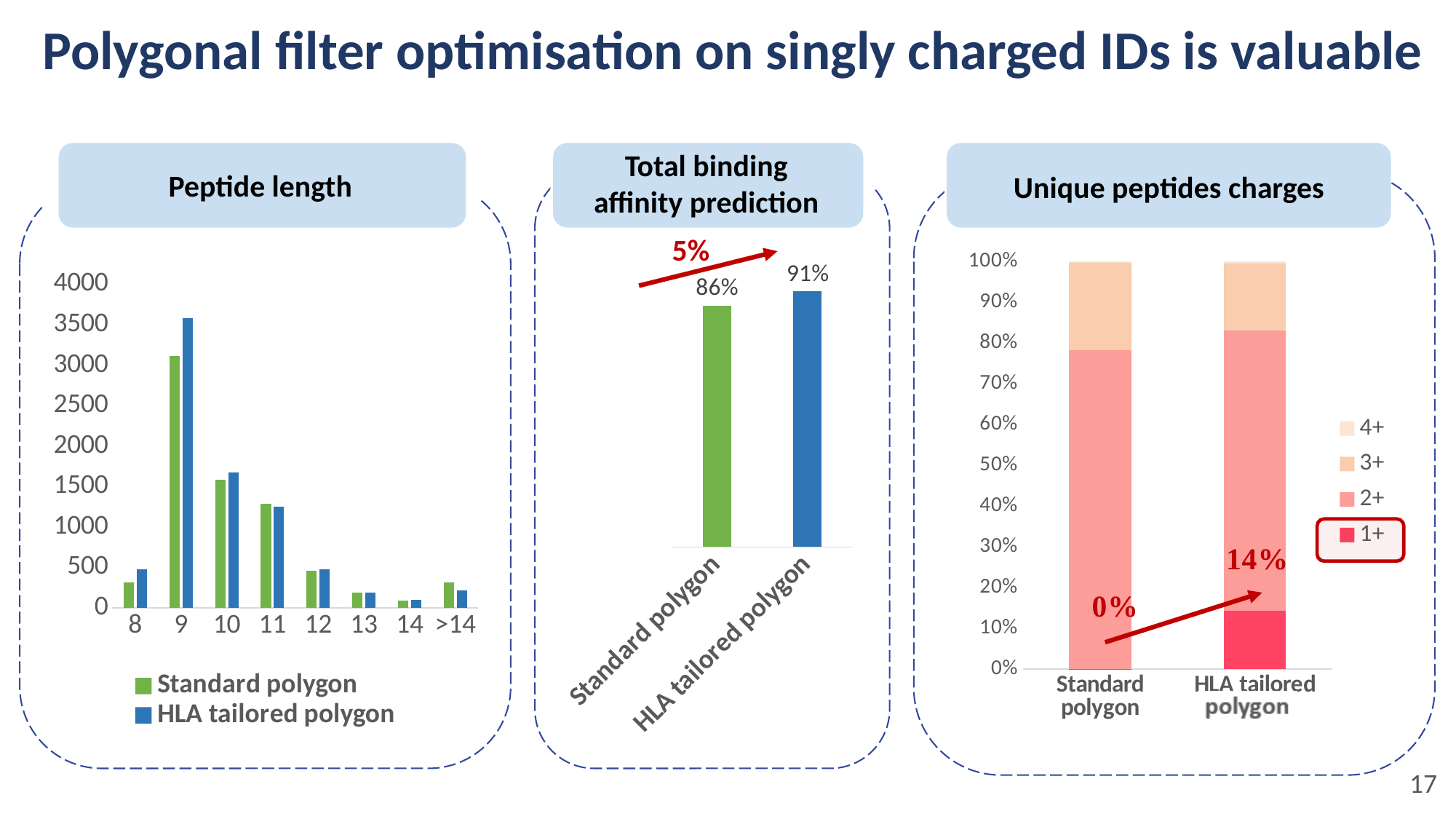
In the Peptide length chart, at which peptide length is the HLA tailored polygon value highest? 9 In the Total binding affinity prediction chart, what is the value for Standard polygon? 86% In the Total binding affinity prediction chart, what is the value for HLA tailored polygon? 91% What kind of chart is the Unique peptides charges chart? Stacked bar chart In the Unique peptides charges chart, what is the share of 1+ charged peptides for Standard polygon? 0% How many peptide length categories are shown on the x axis of the Peptide length chart? 8 In the Total binding affinity prediction chart, which has the higher value, Standard polygon or HLA tailored polygon? HLA tailored polygon How many series does the legend of the Unique peptides charges chart list? 4 In the Peptide length chart, is the HLA tailored polygon value at length 9 greater or less than 3000? greater In the Total binding affinity prediction chart, what is the difference between the HLA tailored polygon and Standard polygon values? 5% In the Peptide length chart, at length 8, which series has the larger value, Standard polygon or HLA tailored polygon? HLA tailored polygon In the Unique peptides charges chart, what is the share of 1+ charged peptides for HLA tailored polygon? 14%